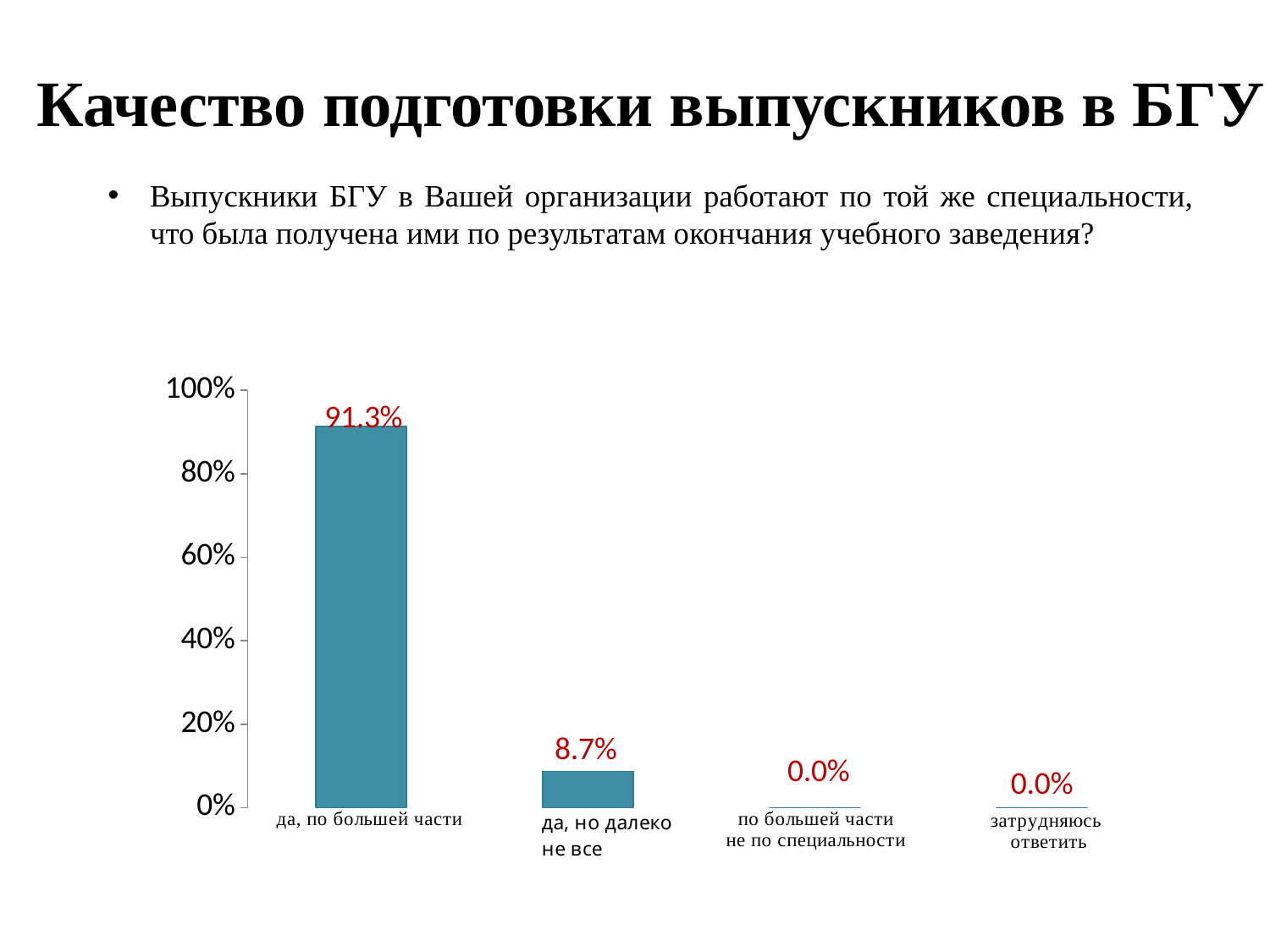
How many categories are shown on the chart? 4 What is the value for "по большей части не по специальности"? 0.0% What kind of chart is shown on the slide? bar chart What is the value for "да, но далеко не все"? 8.7% What is the value for "да, по большей части"? 91.3% Is the value for "да, по большей части" greater or less than 80%? greater What is the difference between the values for "да, по большей части" and "да, но далеко не все"? 82.6% What is the highest value shown on the vertical axis? 100% Is the value for "да, но далеко не все" greater or less than 20%? less Which is larger: the value for "да, по большей части" or "да, но далеко не все"? да, по большей части Which category has the highest value? да, по большей части What is the value for "затрудняюсь ответить"? 0.0%